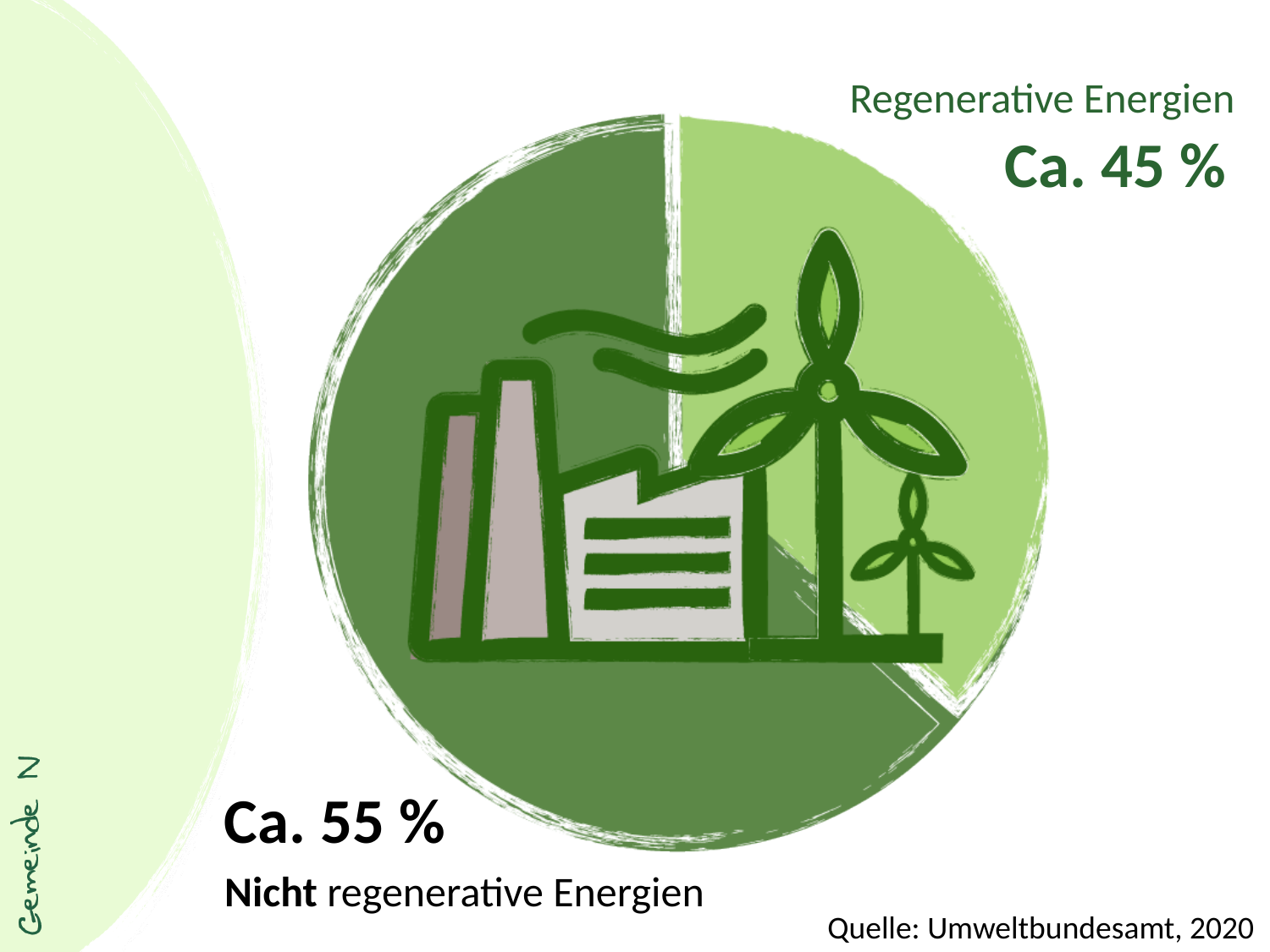
By how many percentage points does the Nicht regenerative Energien share exceed the Regenerative Energien share, according to the printed labels? 10 percentage points How many slices does the pie chart have? 2 Which category has the larger slice of the pie chart? Nicht regenerative Energien Is the share for Nicht regenerative Energien greater or less than 50 %? greater What source is cited for the chart data? Umweltbundesamt, 2020 Which category has the smaller slice of the pie chart? Regenerative Energien What kind of chart is shown on the slide? Pie chart Is the share for Regenerative Energien greater or less than 50 %? less Which slice of the pie chart is shown in the lighter green colour? Regenerative Energien What share of the pie chart is labelled for Nicht regenerative Energien? Ca. 55 % What share of the pie chart is labelled for Regenerative Energien? Ca. 45 % Is the slice for Regenerative Energien larger or smaller than the slice for Nicht regenerative Energien? smaller